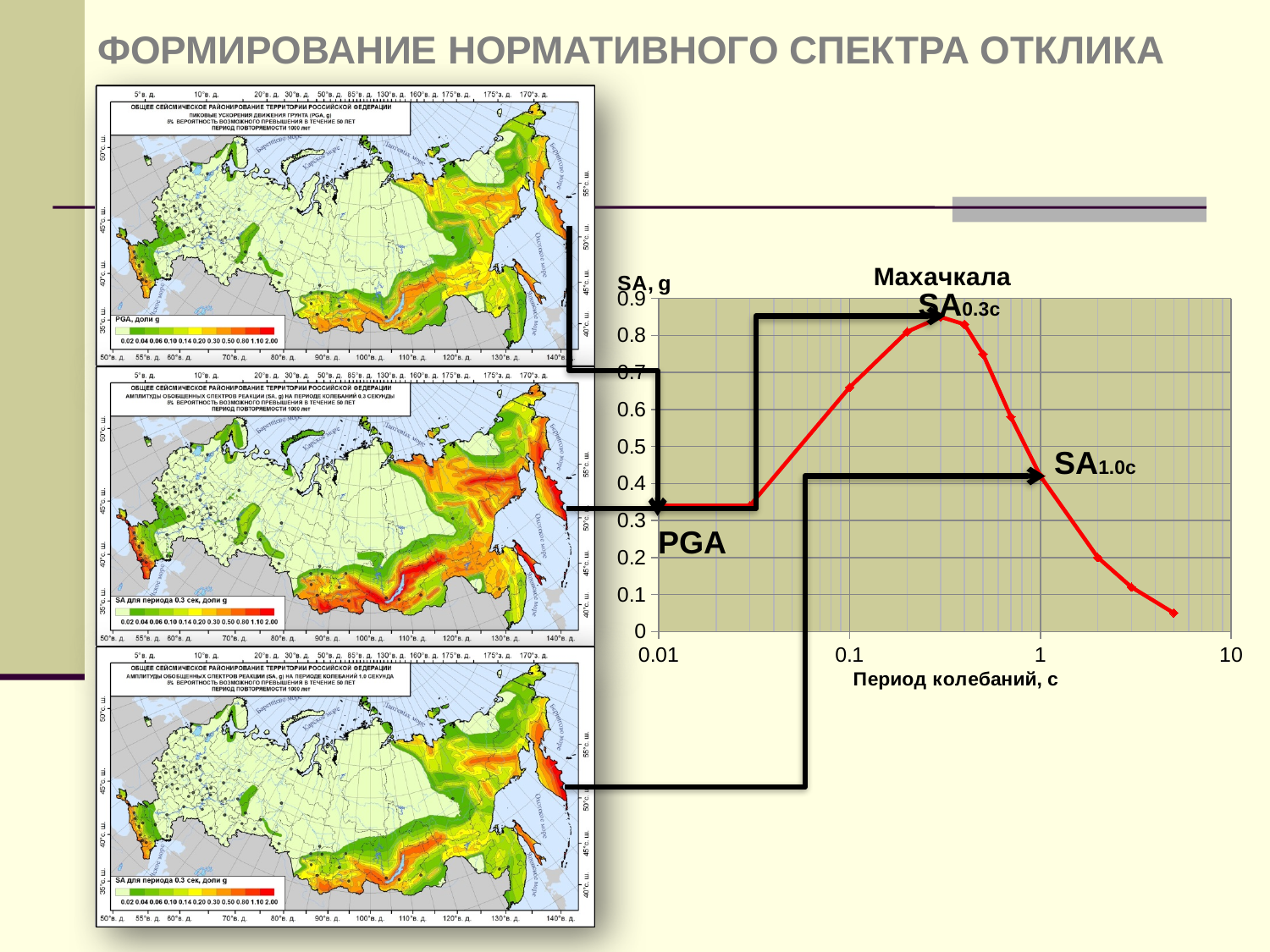
In the chart on the right, which of the three labeled points — PGA, SA0.3c or SA1.0c — has the highest value? SA0.3c In the chart on the right, what is the label of the x axis? Период колебаний, с In the chart on the right, which is larger: the value at a period of 0.1 s or the value at a period of 1 s? the value at 0.1 s In the chart on the right, is the value at the last plotted point (period about 5 s) greater or less than 0.1? less In the chart on the right, is the value at a period of 0.1 s greater or less than 0.5? greater In the chart on the right, does the curve rise or fall as the period increases from 1 s to 10 s? fall In the chart on the right, is the value at a period of 0.01 s (PGA) greater or less than 0.4? less How many labeled tick values are shown on the x axis of the chart on the right? 4 In the chart on the right, what is the label of the y axis? SA, g What kind of chart is shown on the right side of the slide? line chart